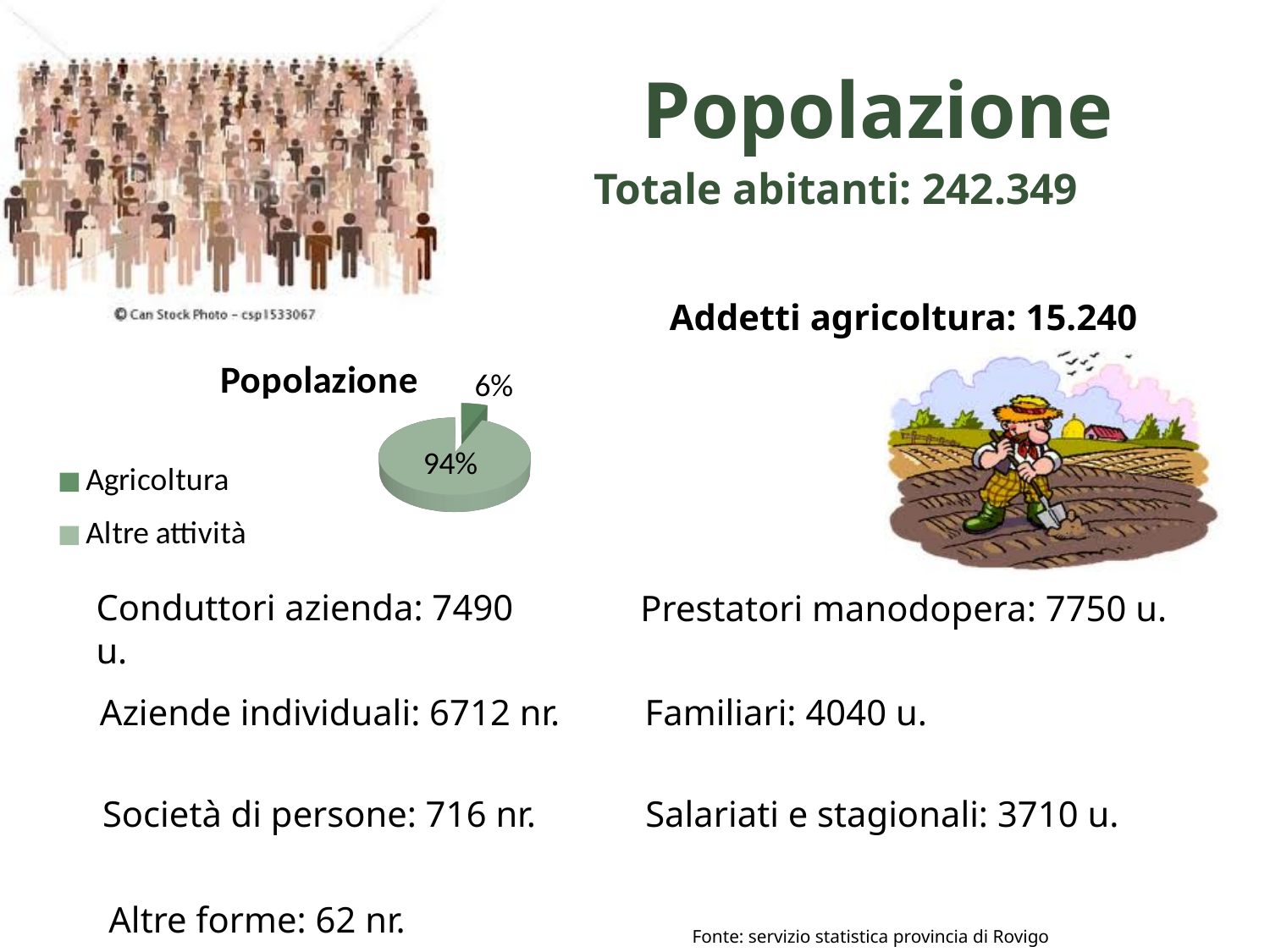
What kind of chart is shown on the slide? pie chart Which is larger, the share for Agricoltura or the share for Altre attività? Altre attività Which slice of the pie is the smallest? Agricoltura How many entries does the legend list? 2 What share of the pie does Altre attività represent? 94% How many slices does the pie chart have? 2 What share of the pie does Agricoltura represent? 6% What is the title of the chart? Popolazione What is the difference in percentage points between the Altre attività slice and the Agricoltura slice? 88 Which slice of the pie is the largest? Altre attività What are the two legend entries of the chart? Agricoltura, Altre attività